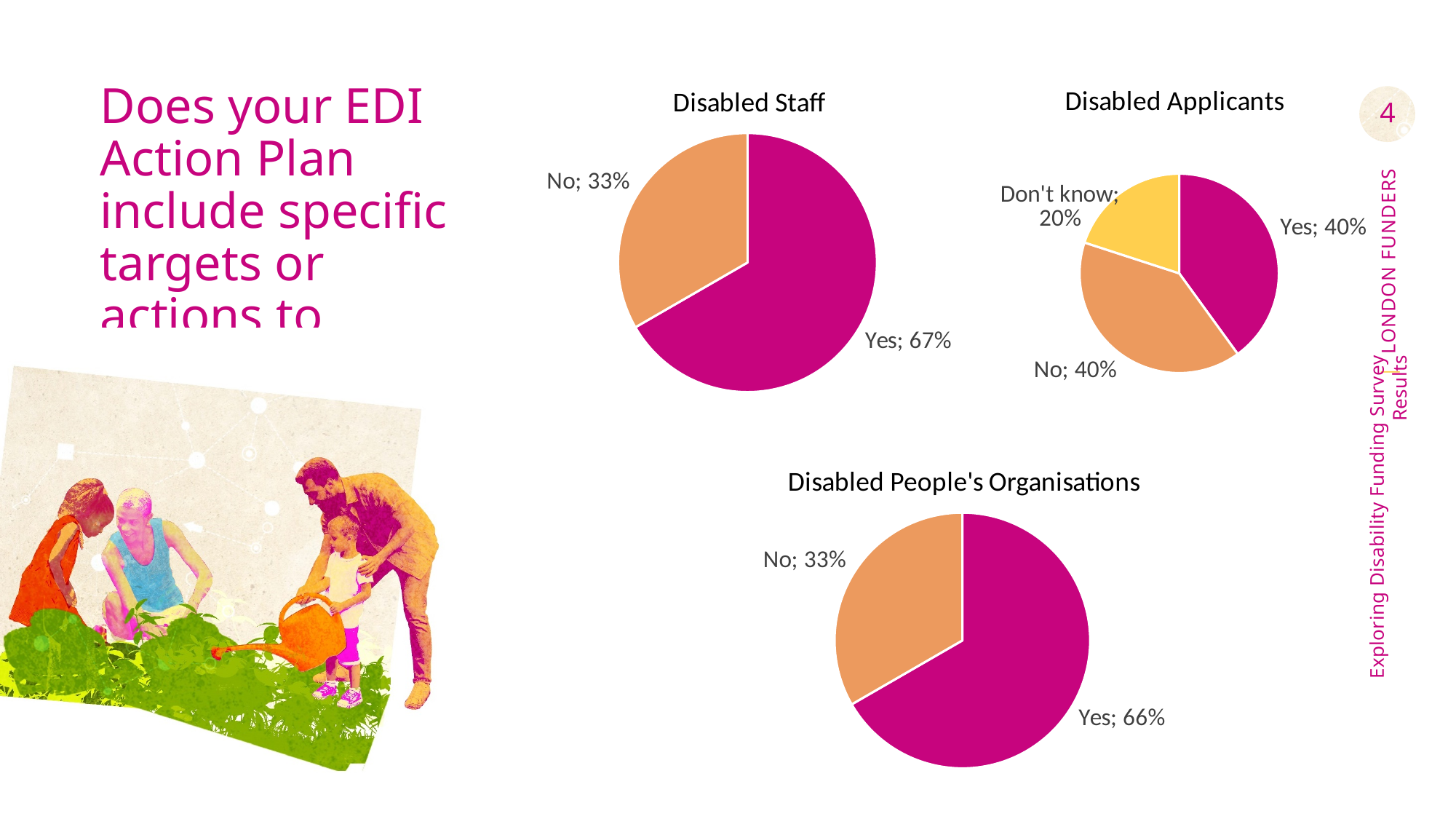
What type of chart is the Disabled People's Organisations chart? Pie chart In the Disabled People's Organisations chart, what percentage answered No? 33% In the Disabled Staff chart, what percentage answered Yes? 67% In the Disabled Applicants chart, what percentage answered Don't know? 20% In the Disabled Applicants chart, what percentage answered Yes? 40% In the Disabled Staff chart, which response has the largest share? Yes In the Disabled People's Organisations chart, what percentage answered Yes? 66% In the Disabled Applicants chart, how many slices are there? 3 In the Disabled Staff chart, what is the difference between the Yes and No percentages? 34% In the Disabled Staff chart, what percentage answered No? 33% In the Disabled Applicants chart, which response has the smallest share? Don't know How many pie charts are shown on the slide? 3